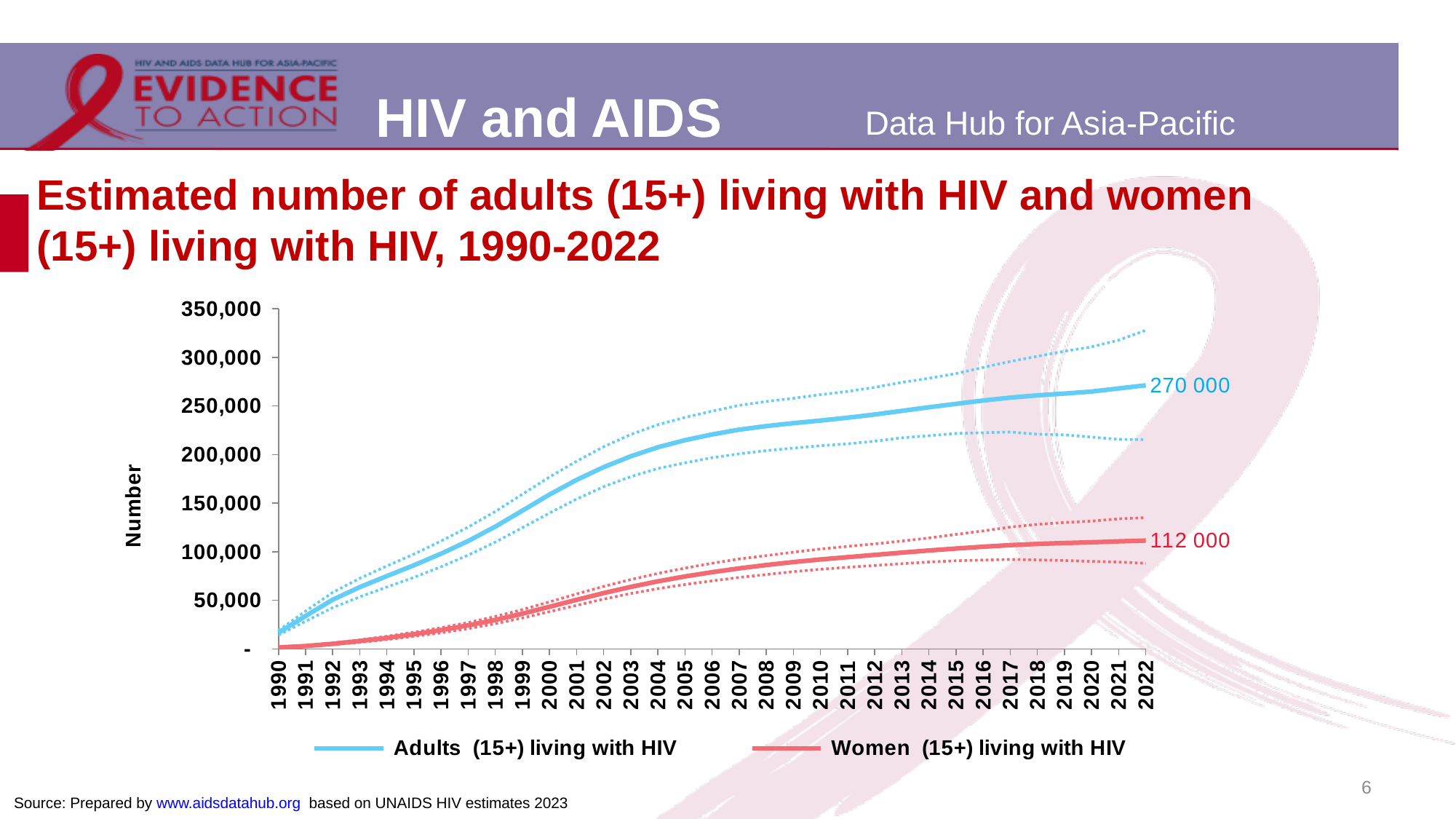
Does the number of adults (15+) living with HIV rise or fall from 1990 to 2022? rise What is the difference between the number of adults (15+) living with HIV and the number of women (15+) living with HIV in 2022? 158 000 What kind of chart is shown on the slide? line chart How many years are shown on the x axis? 33 How many series does the legend list? 2 What is the estimated number of women (15+) living with HIV in 2022? 112 000 What is the estimated number of adults (15+) living with HIV in 2022? 270 000 Is the value for Adults (15+) living with HIV in 1995 greater or less than 100,000? less What is the title of the y axis? Number In 2022, which series has the larger value: Adults (15+) living with HIV or Women (15+) living with HIV? Adults (15+) living with HIV Is the value for Adults (15+) living with HIV in 2010 greater or less than 200,000? greater